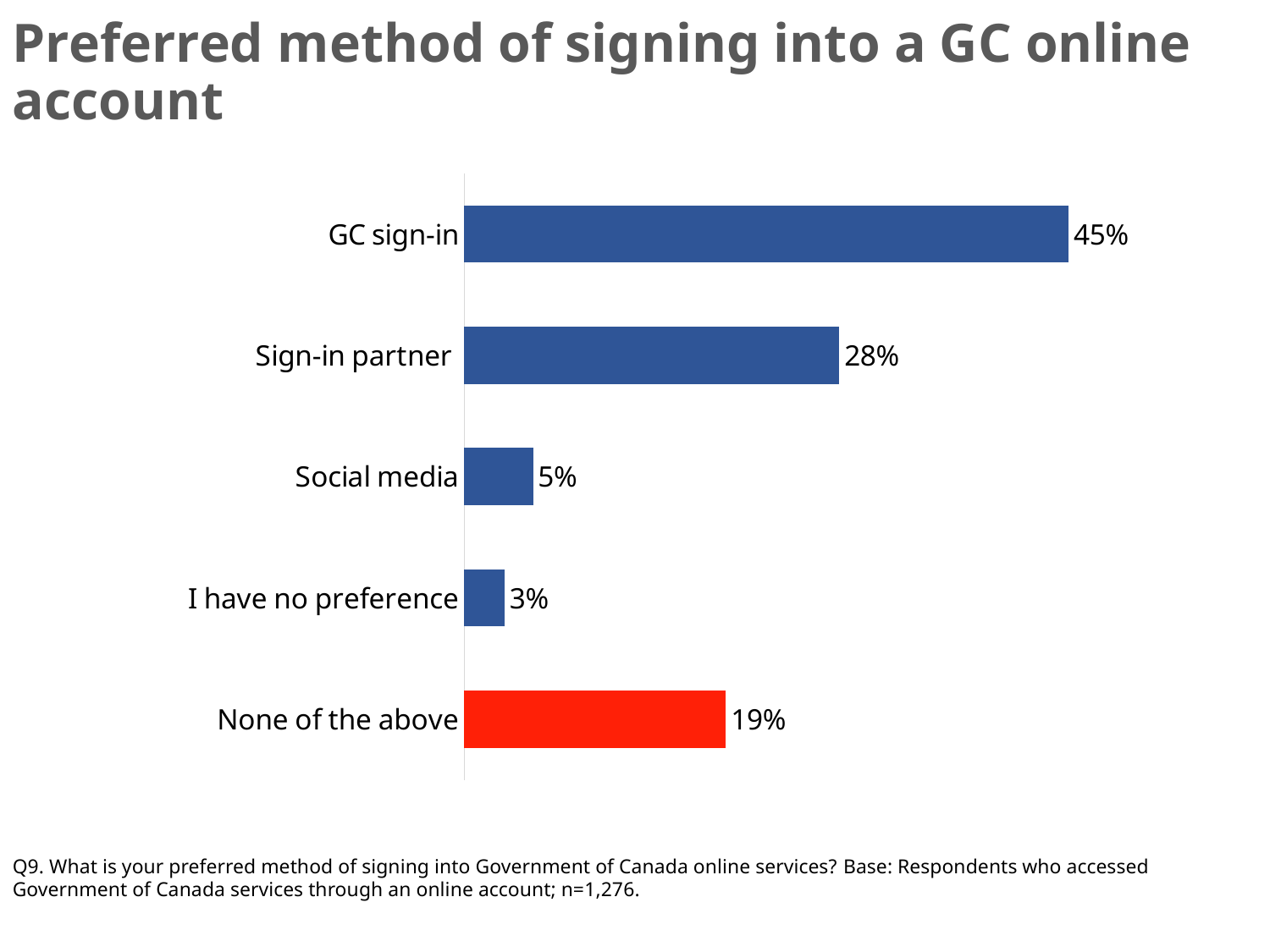
What percentage of respondents prefer GC sign-in? 45% What is the difference between None of the above and Social media? 14% What is the value for None of the above? 19% How many categories are shown in the chart? 5 What is the value for Sign-in partner? 28% Which is larger, Sign-in partner or None of the above? Sign-in partner What percentage chose Social media? 5% What kind of chart is shown on the slide? Bar chart Which bar is coloured red? None of the above Which category has the highest value? GC sign-in What is the difference between GC sign-in and Sign-in partner? 17% Which category has the lowest value? I have no preference